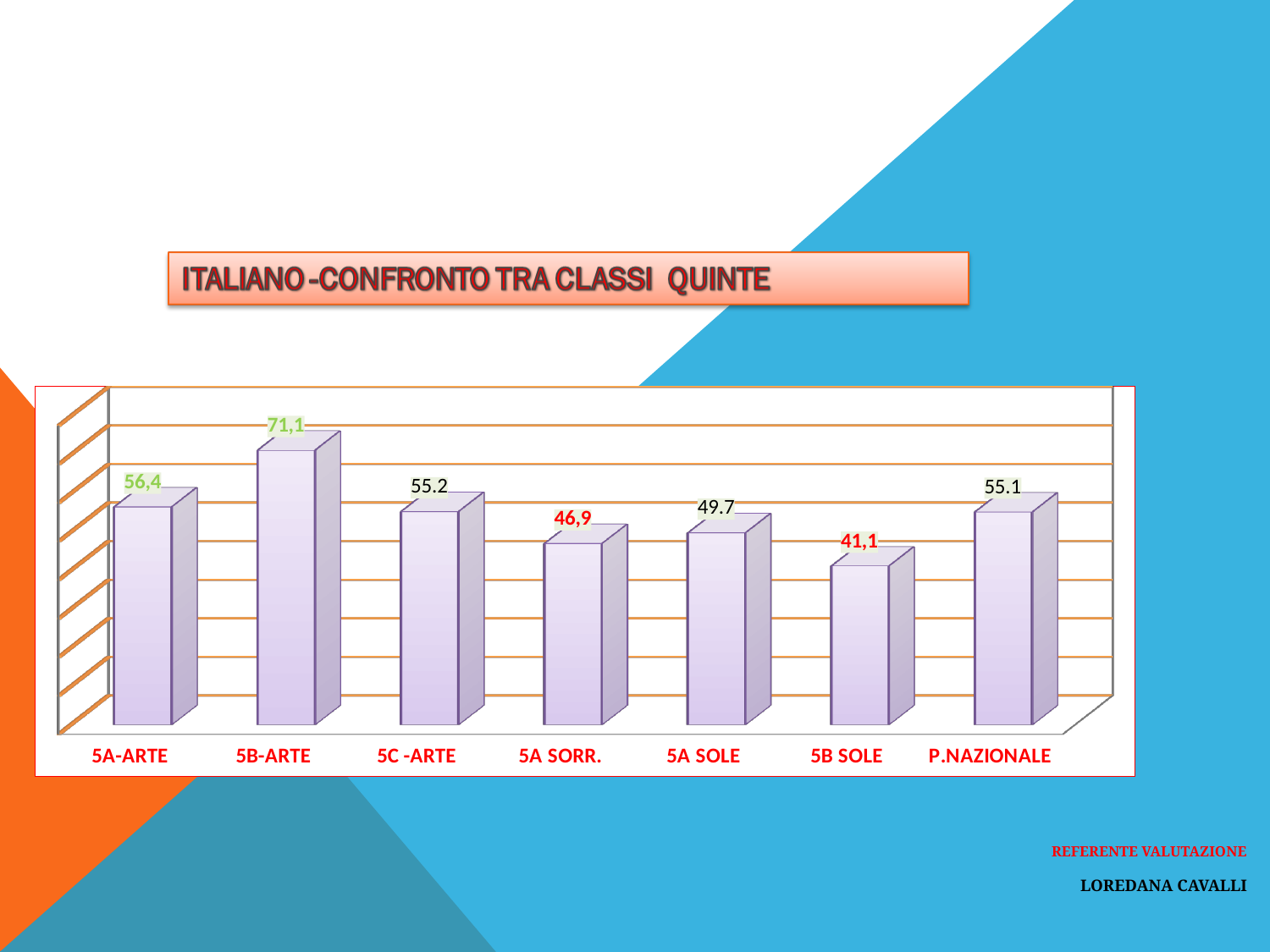
Which category has the highest value? 5B-ARTE What is the difference between the values for 5B-ARTE and 5B SOLE? 30 Which category has the lowest value? 5B SOLE What is the value for 5B-ARTE? 71,1 What is the difference between the values for 5A-ARTE and 5A SORR.? 9,5 What is the value for P.NAZIONALE? 55.1 What is the value for 5A SOLE? 49.7 Which is larger, the value for 5A SOLE or the value for 5A SORR.? 5A SOLE What kind of chart is shown on the slide? Bar chart What is the title of the chart? ITALIANO -CONFRONTO TRA CLASSI QUINTE What is the value for 5B SOLE? 41,1 How many categories are shown on the x axis? 7